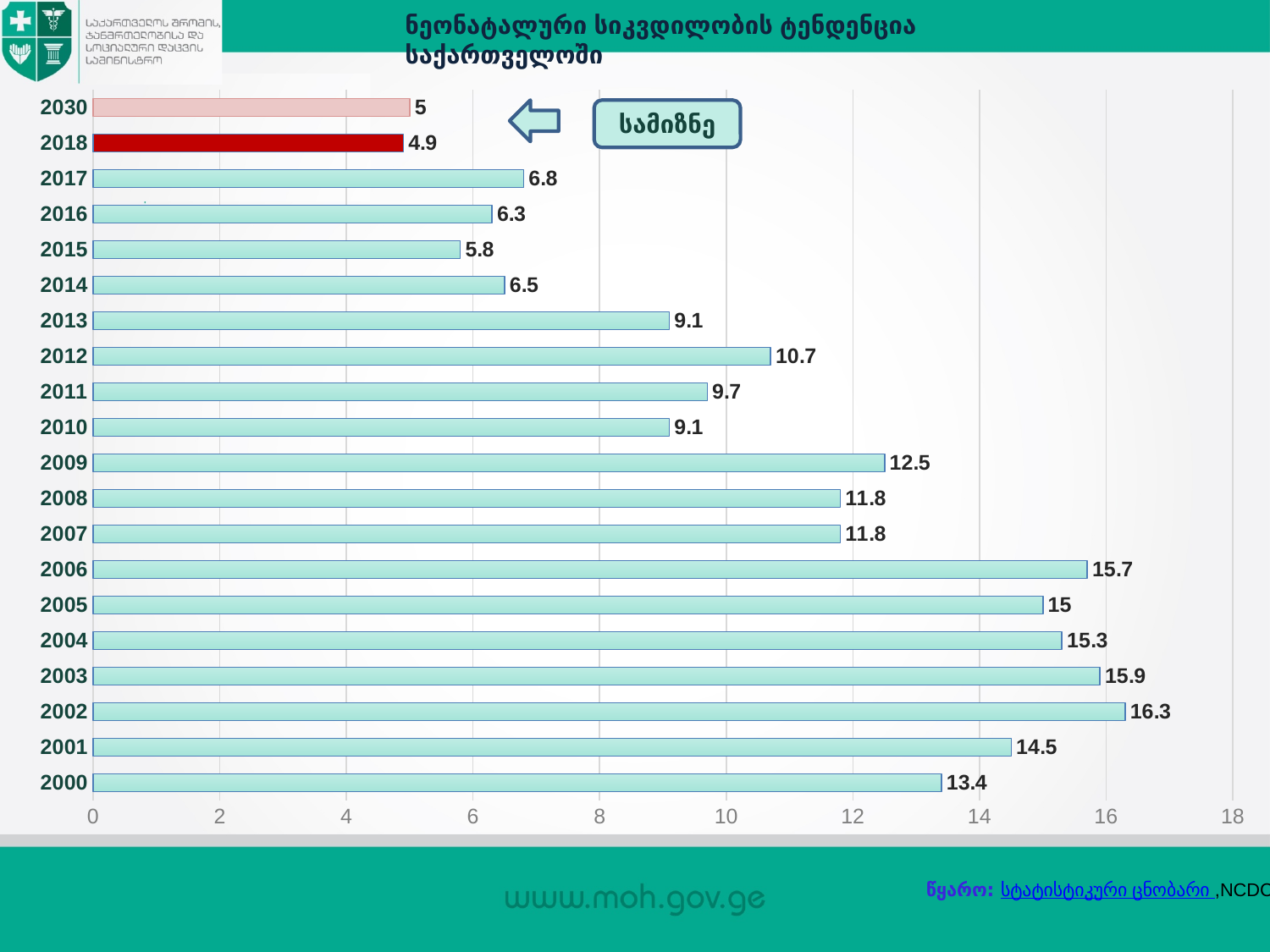
How many bars are plotted on the chart? 20 Which bar is drawn in dark red on the chart? 2018 Which year has the highest value on the chart? 2002 What is the difference between the values for 2006 and 2005? 0.7 What is the value shown for 2018? 4.9 What is the value shown for the 2030 bar? 5 What is the value shown for 2002? 16.3 Which is larger, the value for 2012 or the value for 2013? 2012 Which year has the lowest value on the chart? 2018 Do the values generally rise or fall from 2000 to 2018? Fall What is the difference between the values for 2000 and 2017? 6.6 What kind of chart is shown on the slide? Bar chart